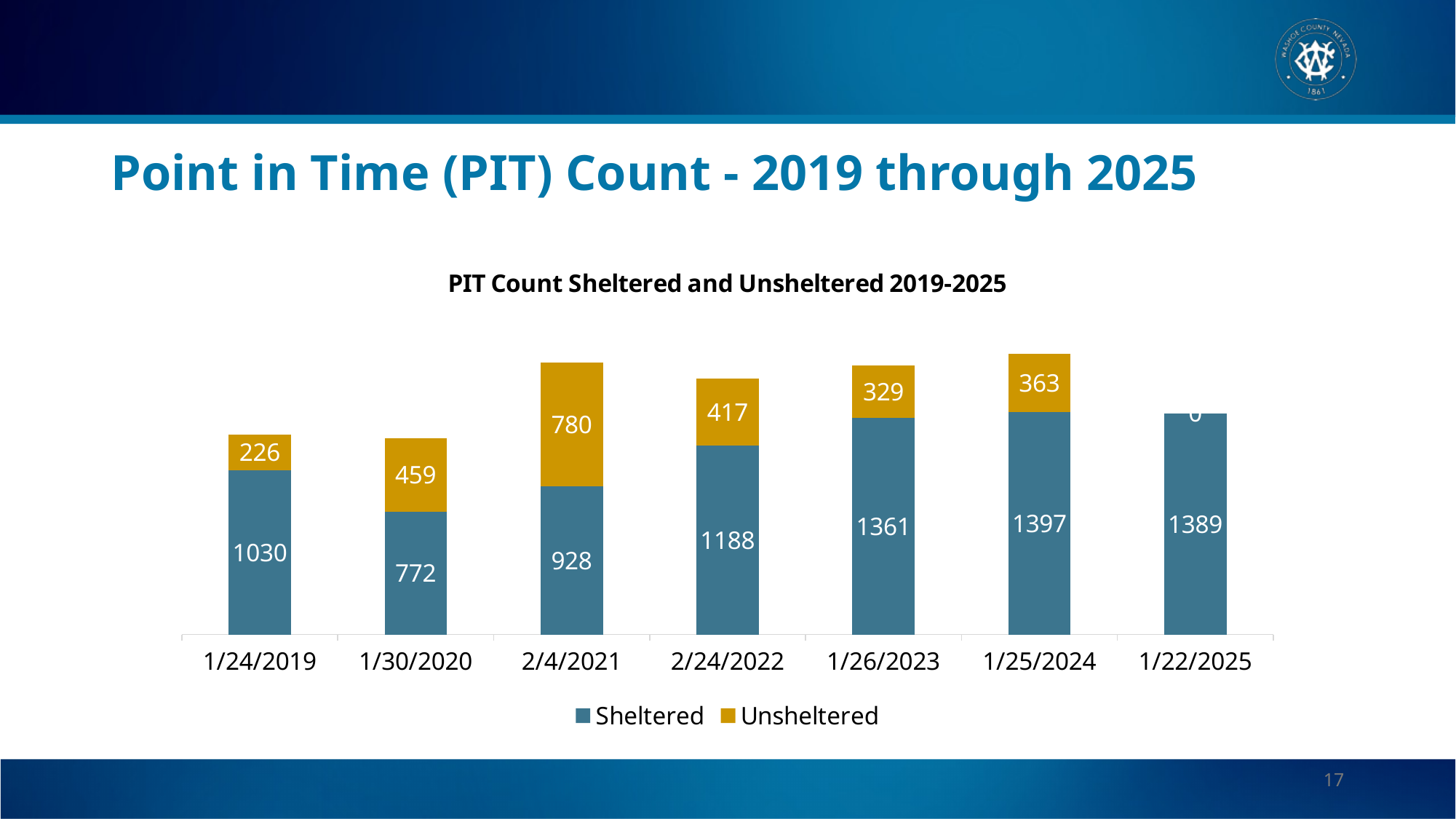
What is the total of the stacked bar for 2/4/2021? 1708 Which date has the highest Unsheltered value? 2/4/2021 Which is larger, the Unsheltered value for 1/30/2020 or for 2/24/2022? 1/30/2020 How many series does the legend list? 2 Which date has the highest Sheltered value? 1/25/2024 What is the Sheltered value for 1/24/2019? 1030 What is the Sheltered value for 1/26/2023? 1361 What kind of chart is shown on the slide? Stacked bar chart Which date has the lowest Sheltered value? 1/30/2020 How many dates are shown on the x axis? 7 What is the difference between the Sheltered values for 1/25/2024 and 1/30/2020? 625 What is the Unsheltered value for 2/4/2021? 780